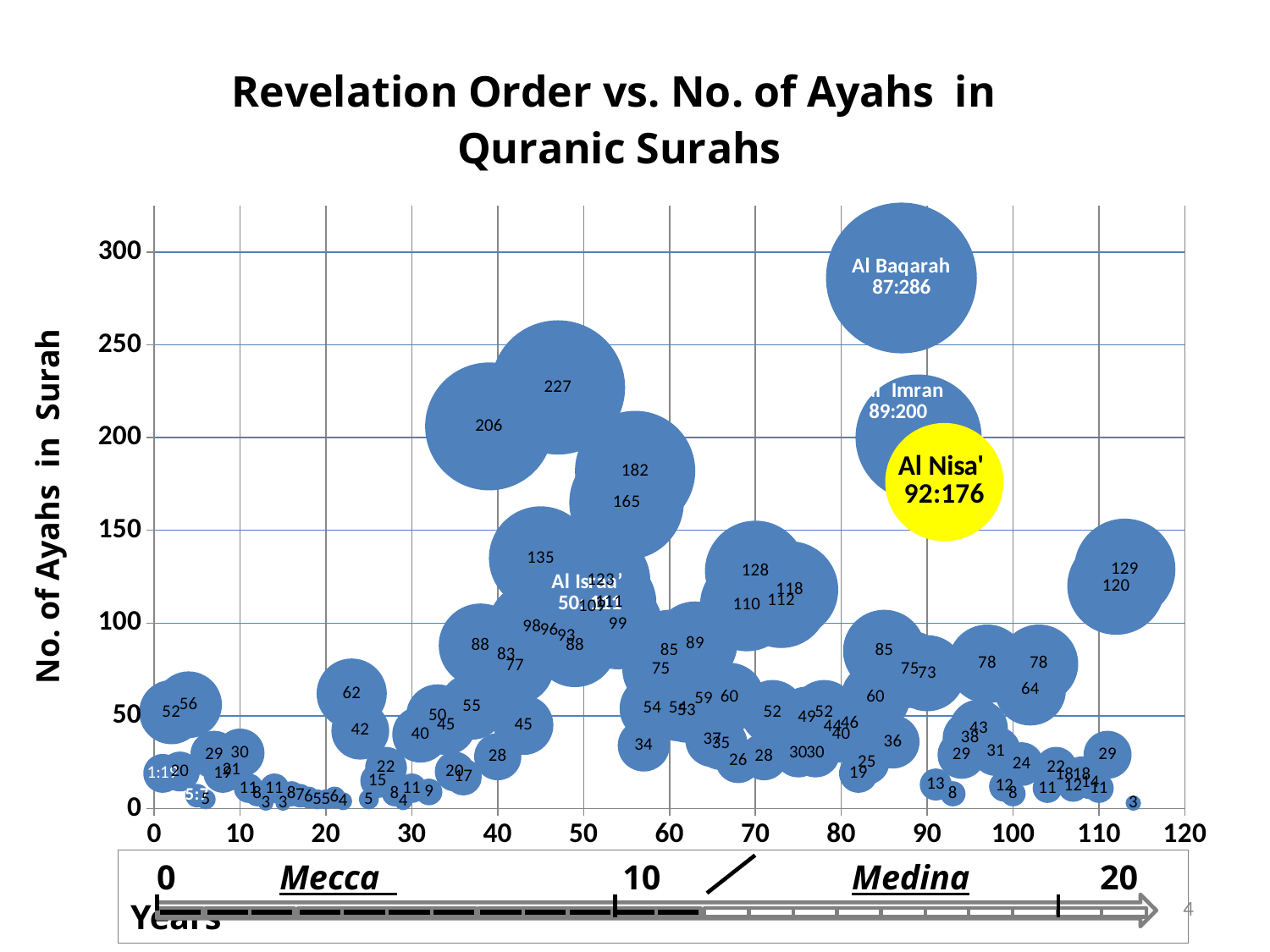
How many ayahs does the Al Nisa' bubble show? 176 Which has more ayahs, Al Baqarah or Al Nisa'? Al Baqarah Is the number of ayahs for Al Nisa' greater or less than 200? less Which surah has the highest number of ayahs on the chart? Al Baqarah Which surah's bubble is highlighted in yellow? Al Nisa' Is the number of ayahs for Al Baqarah greater or less than 250? greater What revelation order number is shown for Al Nisa'? 92 What is the difference in number of ayahs between Al Baqarah (286) and Al Nisa' (176)? 110 How many ayahs does the Al Baqarah bubble show? 286 What kind of chart is shown on the slide? bubble chart What is the title of the chart? Revelation Order vs. No. of Ayahs in Quranic Surahs What revelation order number is shown for Al Baqarah? 87